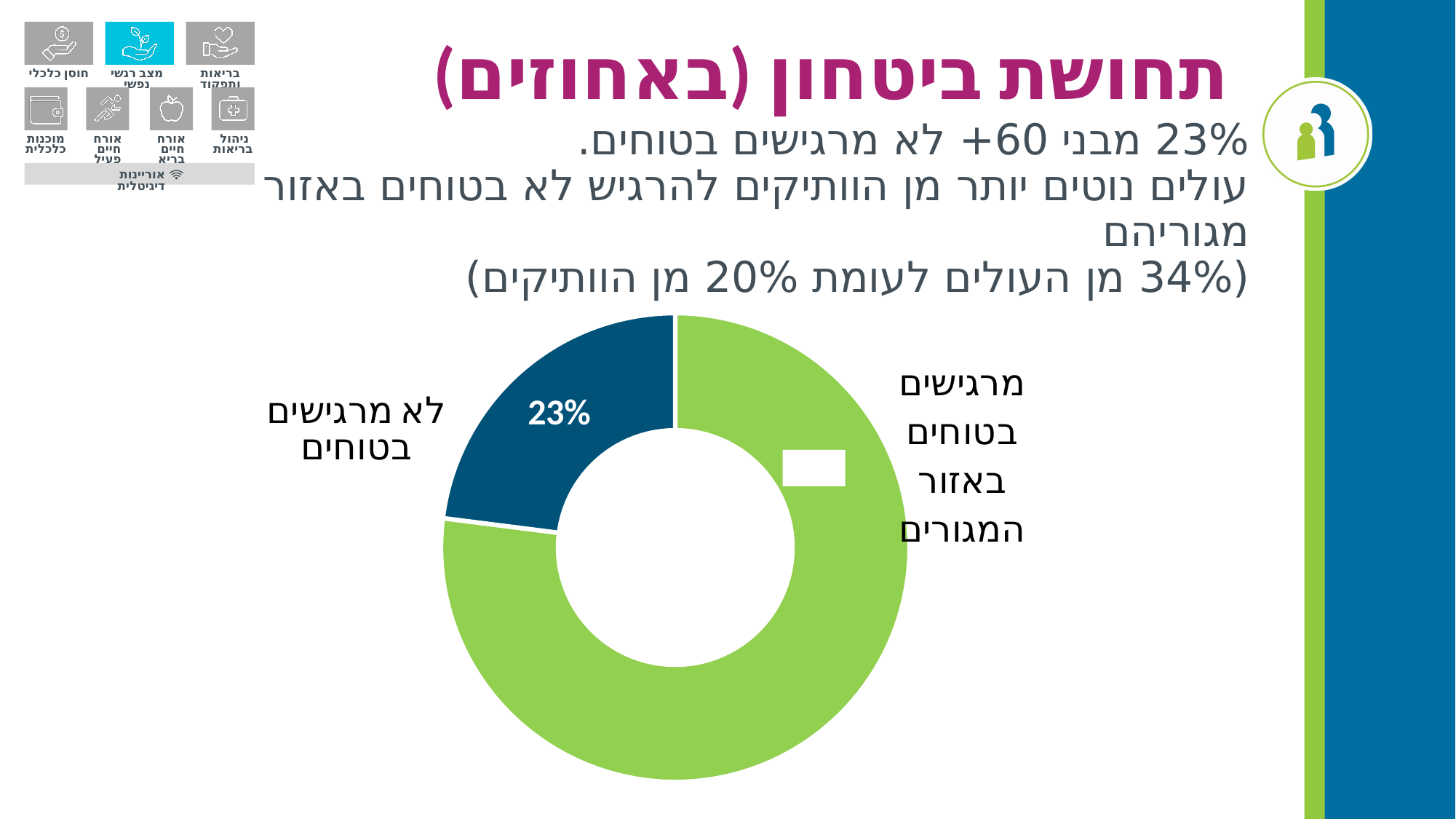
What share of the pie does the 'לא מרגישים בטוחים' slice represent? 23% How many slices does the pie chart have? 2 What kind of chart is shown on the slide? pie chart (donut) What is the title of the slide containing the pie chart? תחושת ביטחון (באחוזים) Which slice is larger: 'מרגישים בטוחים באזור המגורים' or 'לא מרגישים בטוחים'? מרגישים בטוחים באזור המגורים What percentage is shown for the slice labelled 'לא מרגישים בטוחים'? 23% What colour is the slice labelled 23%? dark blue Which slice of the pie chart is the largest? מרגישים בטוחים באזור המגורים Which slice of the pie chart is the smallest? לא מרגישים בטוחים